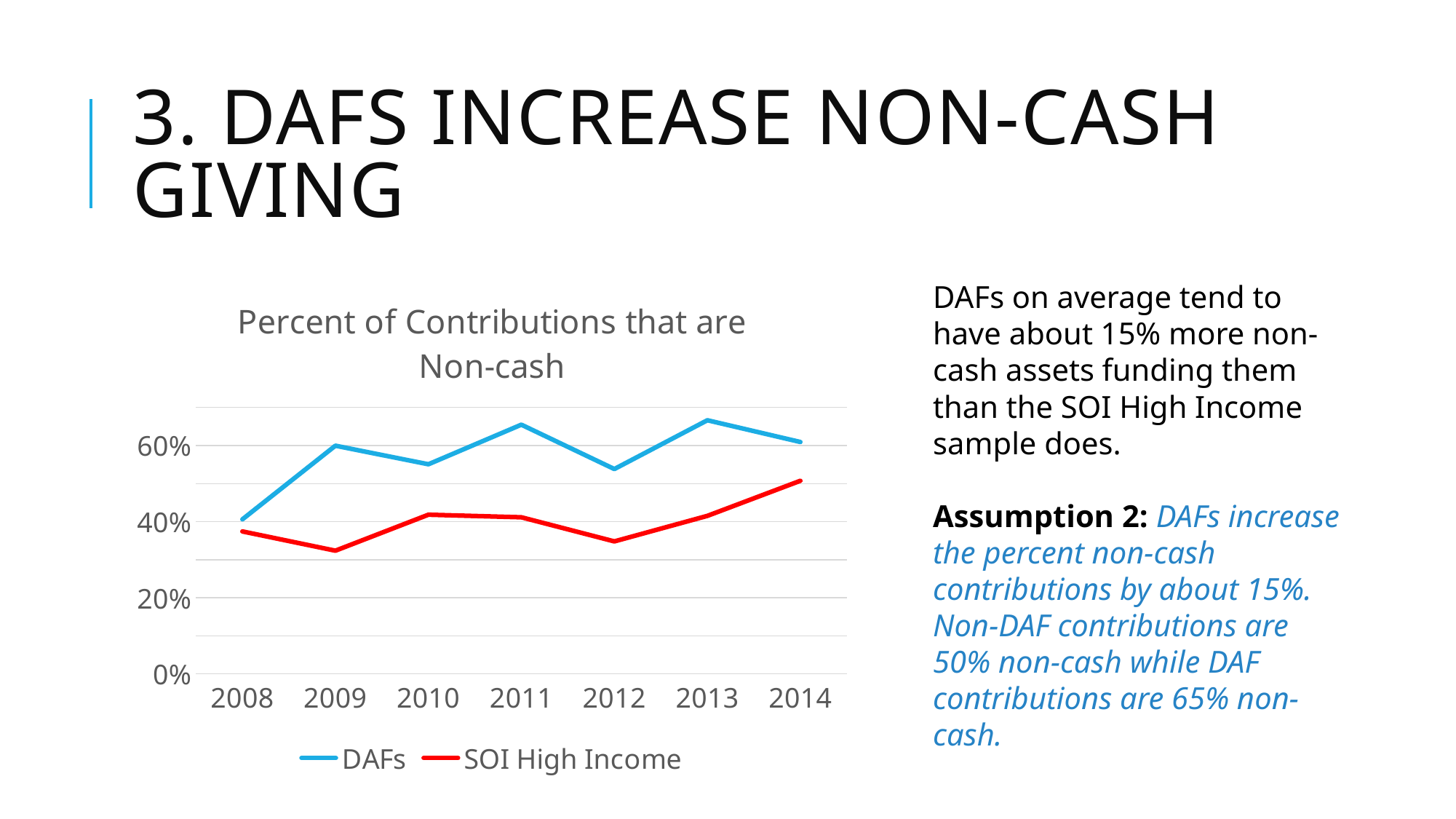
Which colour is used for the DAFs line in the chart? Blue What kind of chart is shown on the slide? Line chart Which series has the larger value in 2011, DAFs or SOI High Income? DAFs How many series does the chart legend list? 2 How many years are shown along the x axis of the chart? 7 Is the DAFs value for 2011 greater or less than 60%? greater In which year is the SOI High Income value highest? 2014 In which year is the SOI High Income value lowest? 2009 Is the SOI High Income value for 2012 greater or less than 40%? less What is the title of the chart? Percent of Contributions that are Non-cash Does the SOI High Income line rise or fall from 2012 to 2014? Rises In which year is the DAFs value lowest? 2008